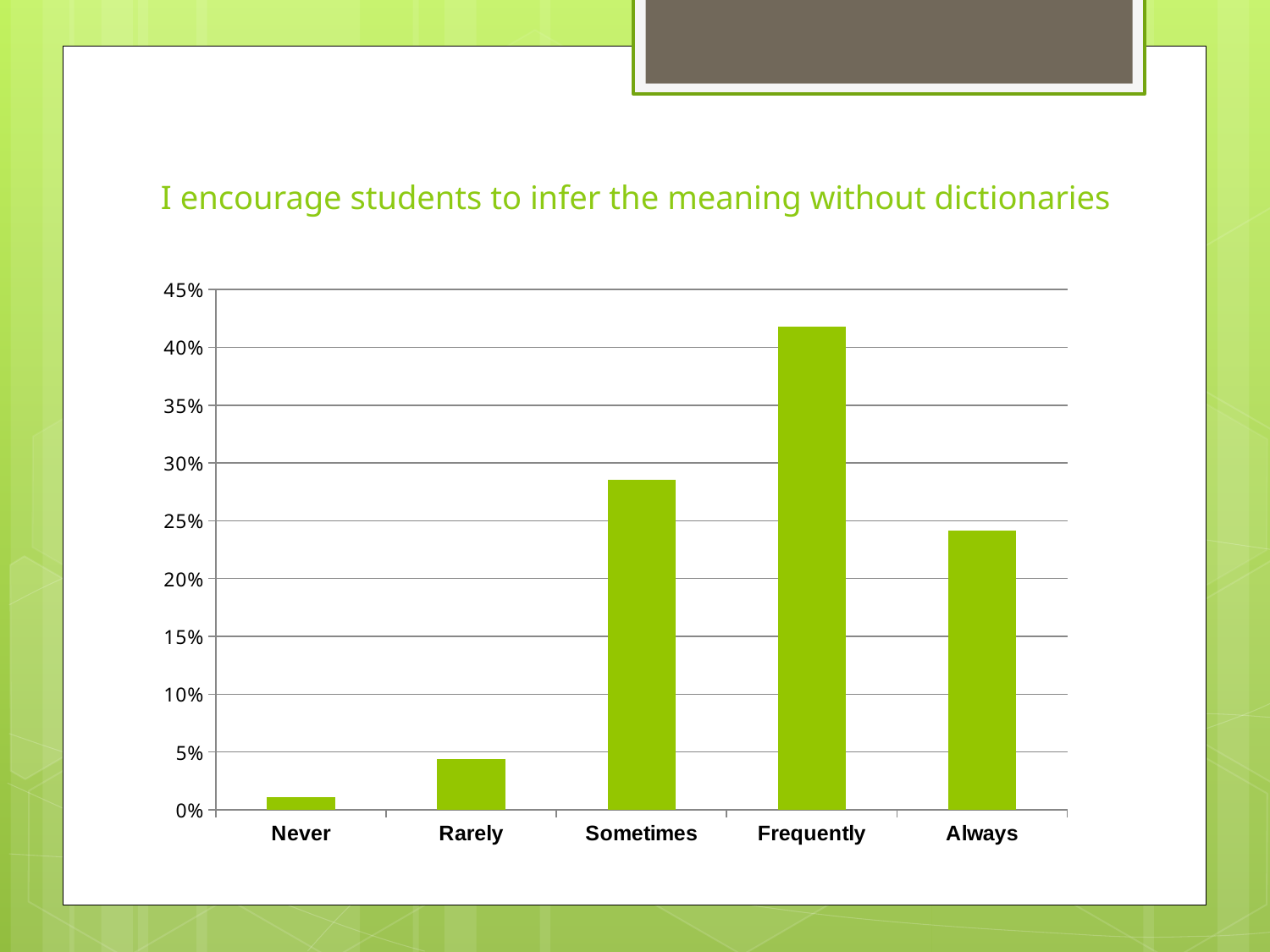
Is the value for Rarely greater or less than 5%? less Is the value for Always greater or less than 20%? greater Is the value for Frequently greater or less than 40%? greater What is the title of the chart? I encourage students to infer the meaning without dictionaries How many categories are shown on the x axis? 5 Do the values rise or fall from Never to Frequently along the x axis? rise Which is larger, the value for Sometimes or the value for Always? Sometimes Which category has the lowest value? Never Which is larger, the value for Never or the value for Rarely? Rarely What kind of chart is shown on the slide? bar chart Which category has the highest value? Frequently